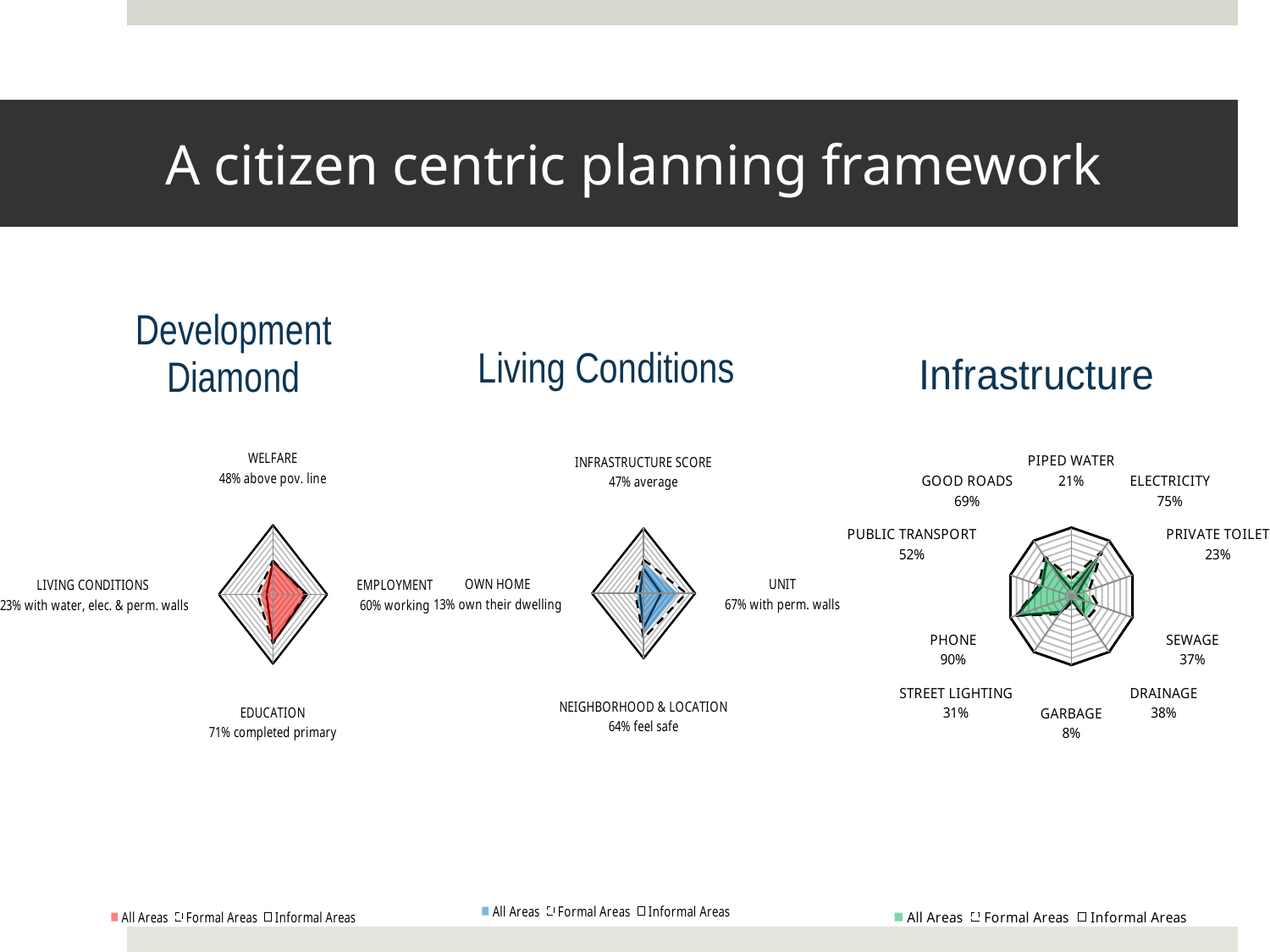
On the Infrastructure chart, which category has the lowest percentage shown? GARBAGE On the Infrastructure chart, how many categories are plotted around the radar? 10 On the Infrastructure chart, which category has the highest percentage shown? PHONE On the Living Conditions chart, which is larger, the percentage for UNIT or for NEIGHBORHOOD & LOCATION? UNIT On the Development Diamond chart, which category has the lowest percentage shown? LIVING CONDITIONS On the Infrastructure chart, what percentage is shown for PHONE? 90% On the Infrastructure chart, what percentage is shown for GARBAGE? 8% How many series does the legend of the Infrastructure chart list? 3 On the Infrastructure chart, what is the difference between the percentages shown for ELECTRICITY and PIPED WATER? 54% What kind of chart is the Living Conditions chart? Radar chart On the Development Diamond chart, what percentage is shown for EDUCATION? 71% On the Living Conditions chart, what percentage is shown for OWN HOME? 13%